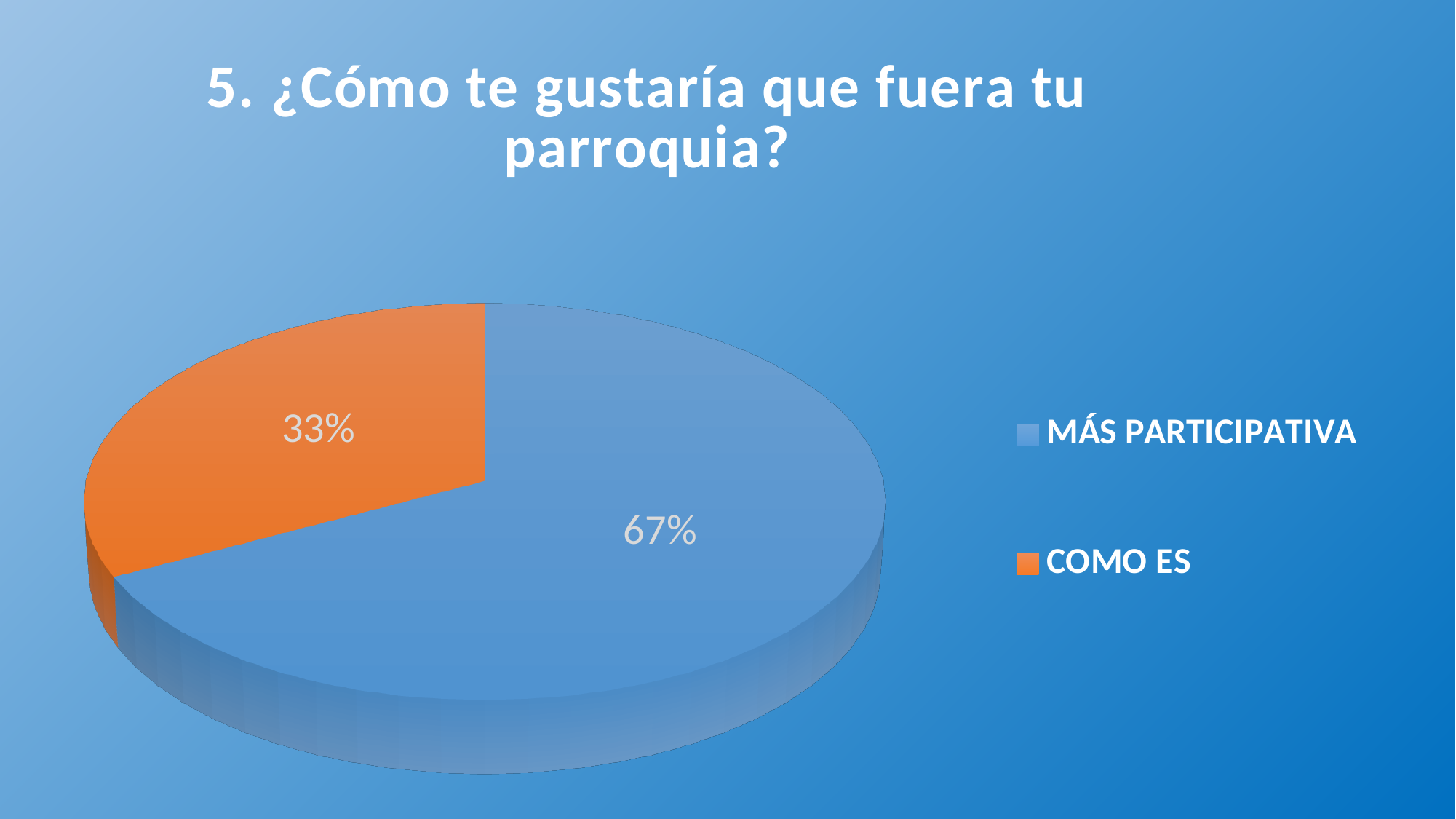
Which is larger, the slice for MÁS PARTICIPATIVA or the slice for COMO ES? MÁS PARTICIPATIVA What share of the pie does MÁS PARTICIPATIVA represent? 67% Which category has the smallest slice of the pie? COMO ES How many categories does the pie chart have? 2 What is the difference in percentage points between MÁS PARTICIPATIVA and COMO ES? 34 How many entries does the legend list? 2 What kind of chart is shown on the slide? pie chart Which category has the largest slice of the pie? MÁS PARTICIPATIVA What is the title of the chart? 5. ¿Cómo te gustaría que fuera tu parroquia? What share of the pie does COMO ES represent? 33% What colour is the slice for COMO ES? orange